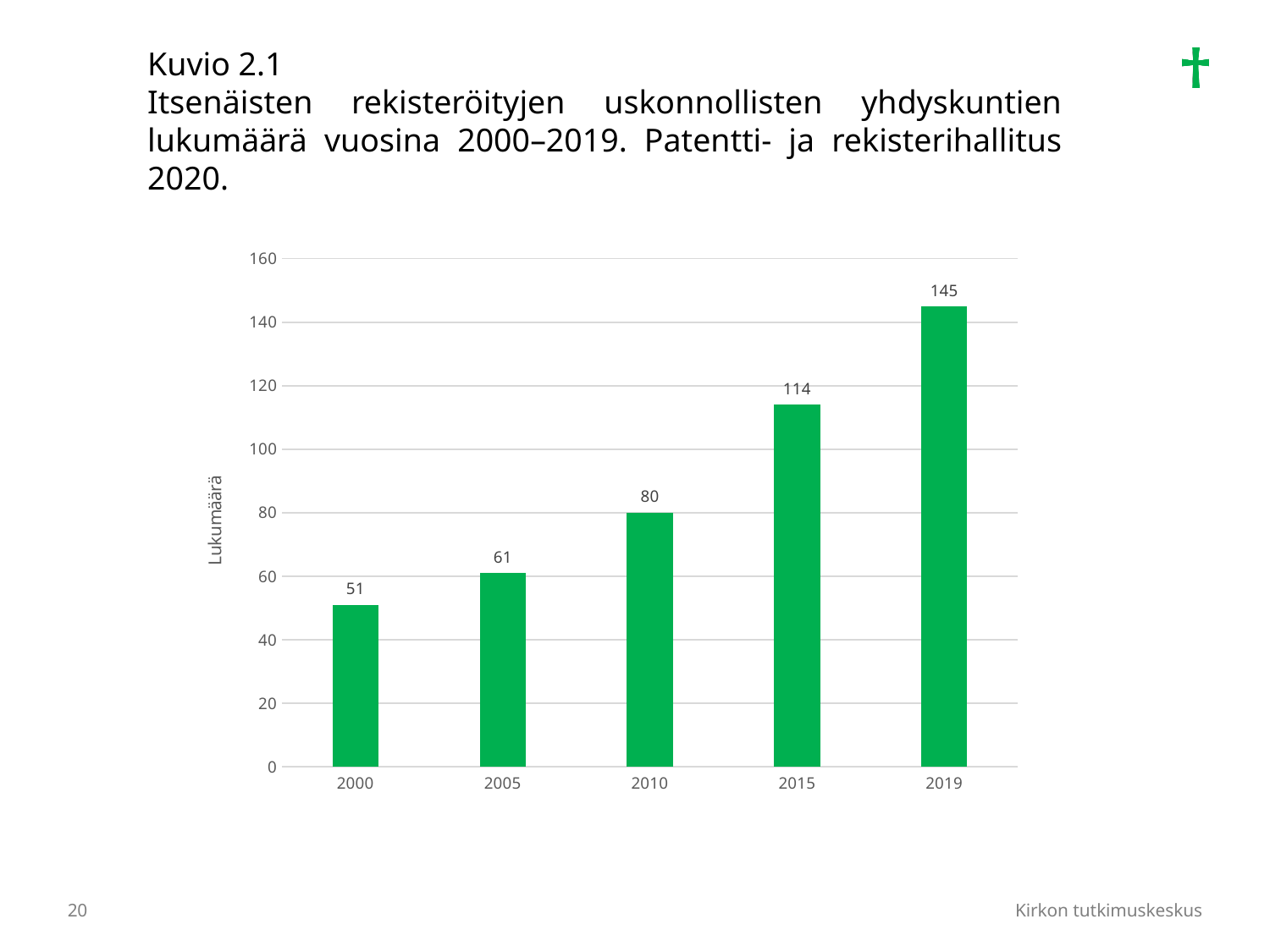
What is the value for 2000? 51 Is the value for 2015 greater or less than 100? greater Which is larger, the value for 2010 or the value for 2005? 2010 What is the value for 2010? 80 What is the value for 2019? 145 Which year has the lowest value? 2000 What is the difference between the values for 2019 and 2015? 31 Which year has the highest value? 2019 How many years are shown on the x axis? 5 What is the difference between the values for 2005 and 2000? 10 What kind of chart is shown on the slide? bar chart Do the values rise or fall from 2000 to 2019? rise